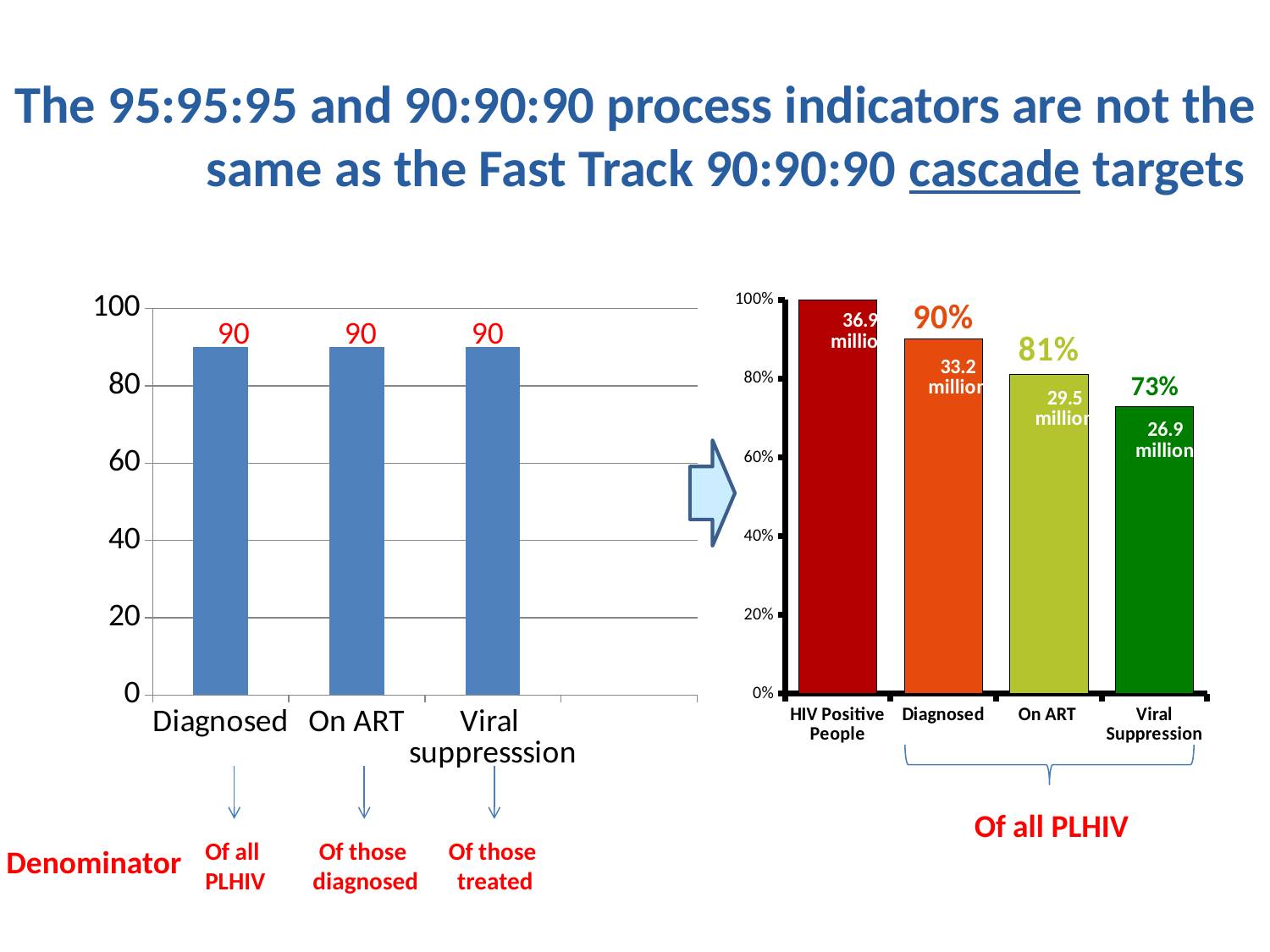
What kind of chart is the left chart? bar chart In the right chart, how many bars are there? 4 In the left chart, how many categories are shown on the x axis? 3 In the right chart, how many million people are labelled on the Diagnosed bar? 33.2 million In the right chart, what percentage is shown for On ART? 81% In the right chart, what percentage is shown for Viral Suppression? 73% In the right chart, how many million people are labelled on the HIV Positive People bar? 36.9 million In the left chart, what is the value for On ART? 90 In the right chart, which category has the highest bar? HIV Positive People In the right chart, do the bars rise or fall from left to right? fall In the right chart, what is the difference in percentage points between Diagnosed and Viral Suppression? 17% In the right chart, which category has the lowest bar? Viral Suppression